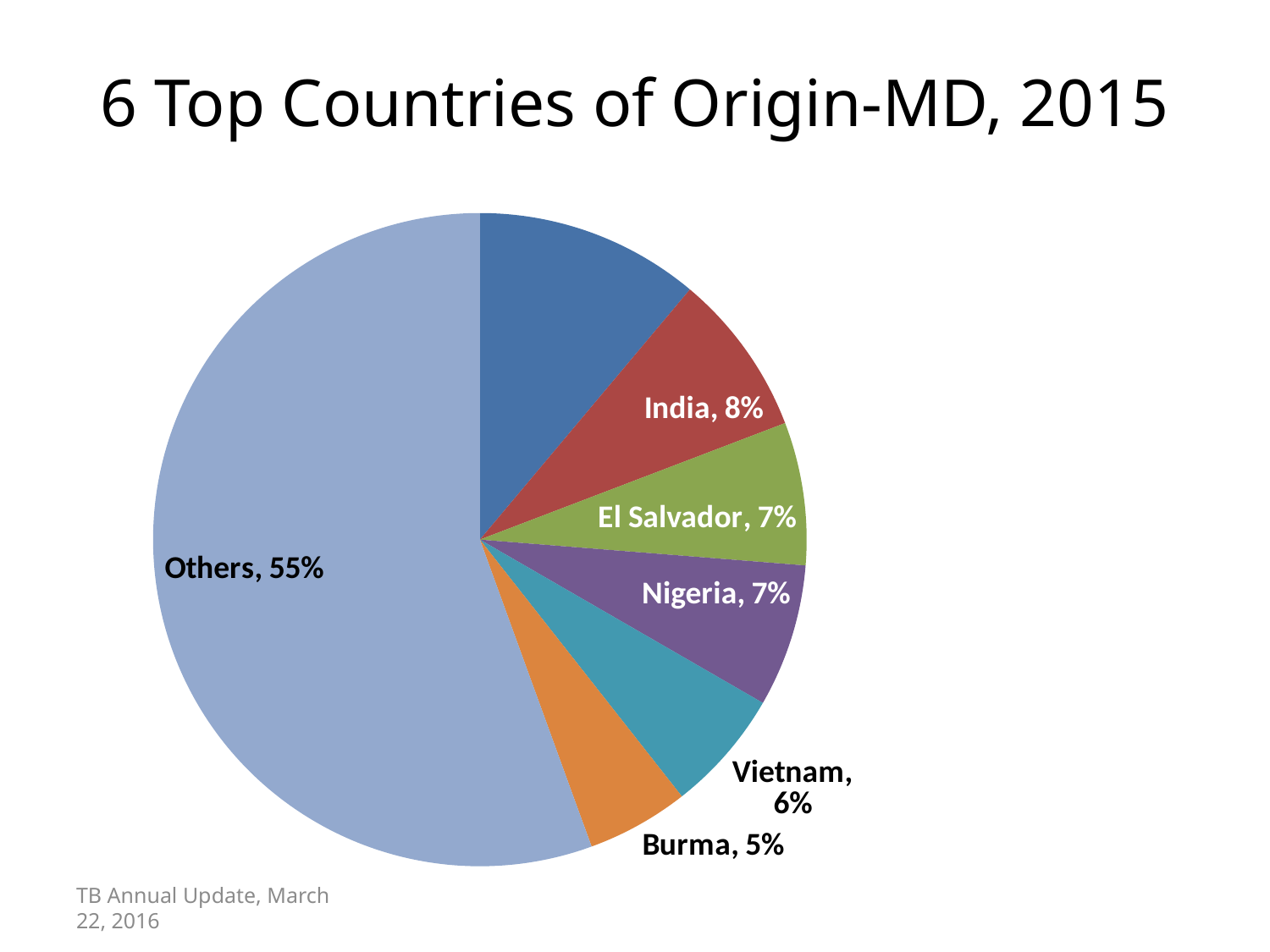
What percentage is shown for Vietnam? 6% What percentage is shown for El Salvador? 7% What kind of chart is shown on the slide? Pie chart How many slices does the pie chart have? 7 What is the title of the slide? 6 Top Countries of Origin-MD, 2015 What percentage is shown for Burma? 5% Which slice of the pie is the largest? Others Which slice of the pie is the smallest? Burma What percentage is shown for Others? 55% What share of the pie is labelled for India? 8% Which has the larger share, India or Vietnam? India What is the difference in percentage points between Others and India? 47